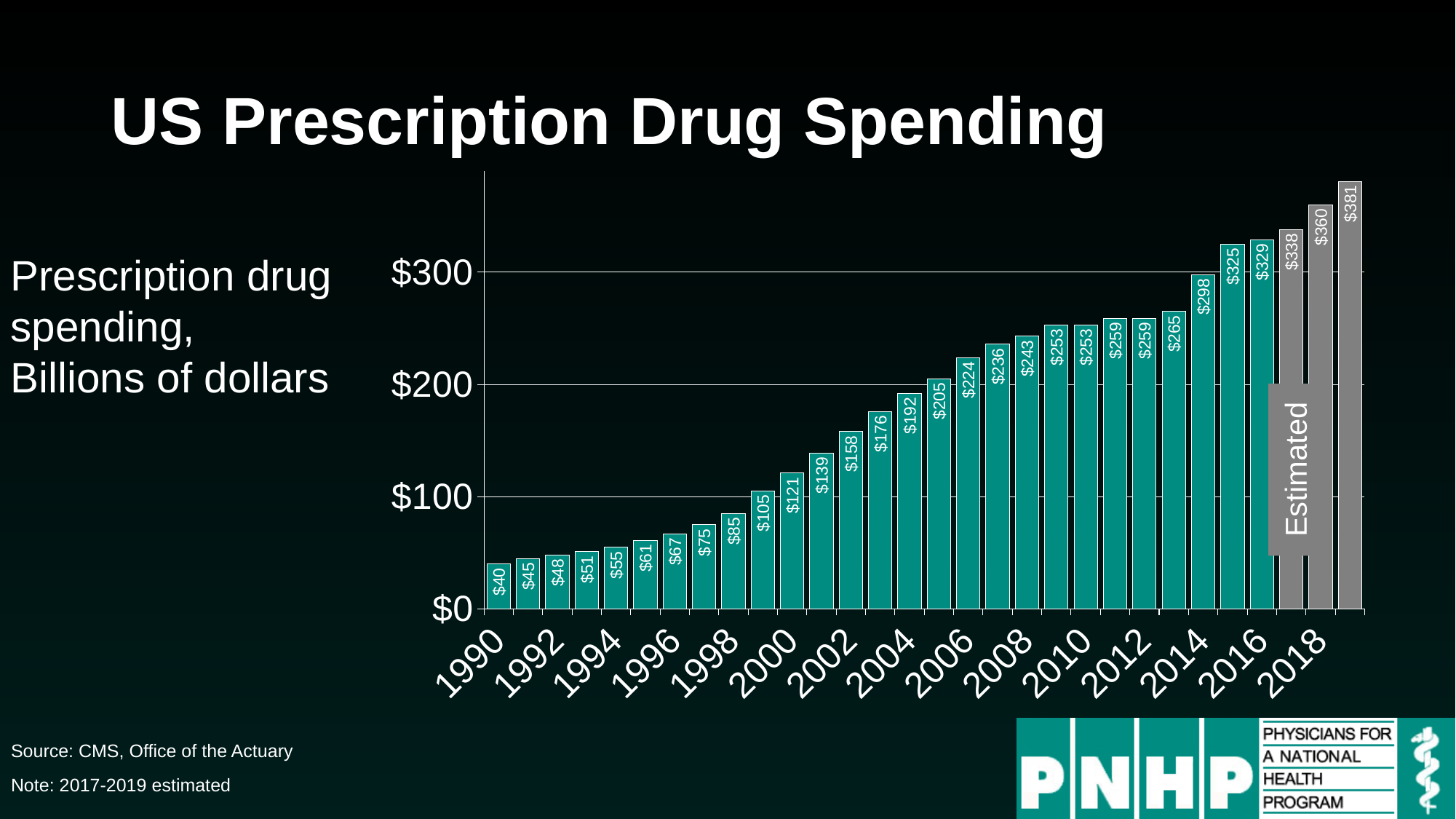
Is the value for 2005 greater or less than $200? greater What is the value for 2000? $121 What kind of chart is shown on the slide? bar chart Which year has the lowest prescription drug spending? 1990 Which year has the highest prescription drug spending? 2019 What is the difference between the values for 2019 and 1990? $341 What is the value for 1990? $40 Do the values rise or fall from 1990 to 2019? rise How many bars are plotted in the chart? 30 Which years are shown as estimated (grey bars)? 2017-2019 Which is larger, the value for 2014 or the value for 2013? 2014 What is the value for 2019? $381